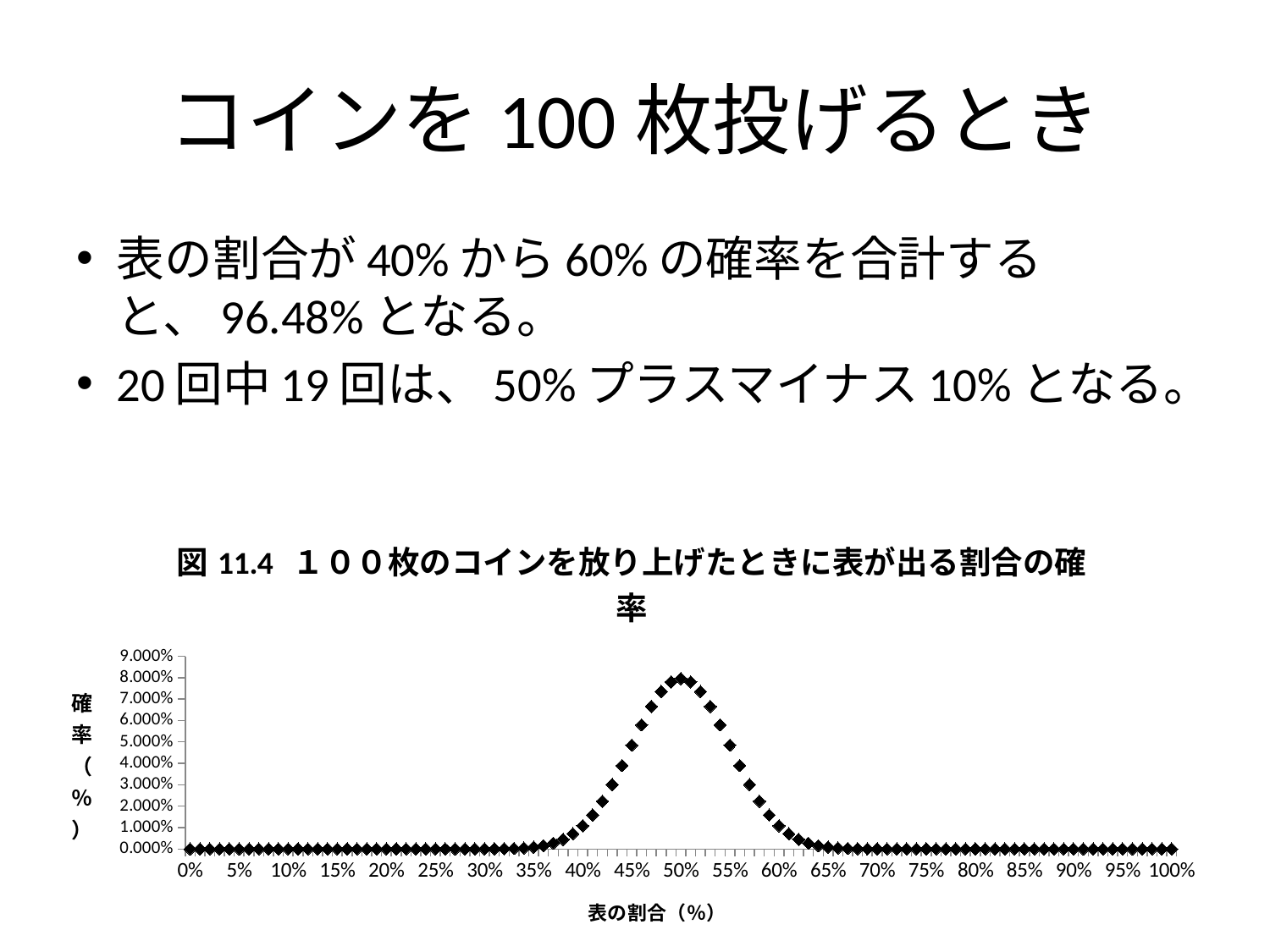
Do the probability values rise or fall as 表の割合 increases from 35% to 50%? rise Is the probability at 表の割合 = 40% greater or less than 2.000%? less What is the title of the horizontal axis? 表の割合（%） What is the highest tick value shown on the vertical axis? 9.000% What kind of chart is shown on the slide? scatter chart Is the probability at 表の割合 = 20% greater or less than 1.000%? less At which value of 表の割合 does the probability reach its highest point? 50% Is the probability at 表の割合 = 60% greater or less than 2.000%? less Which has the higher probability: 表の割合 = 50% or 表の割合 = 40%? 50% Which has the higher probability: 表の割合 = 45% or 表の割合 = 35%? 45% Do the probability values rise or fall as 表の割合 increases from 50% to 100%? fall